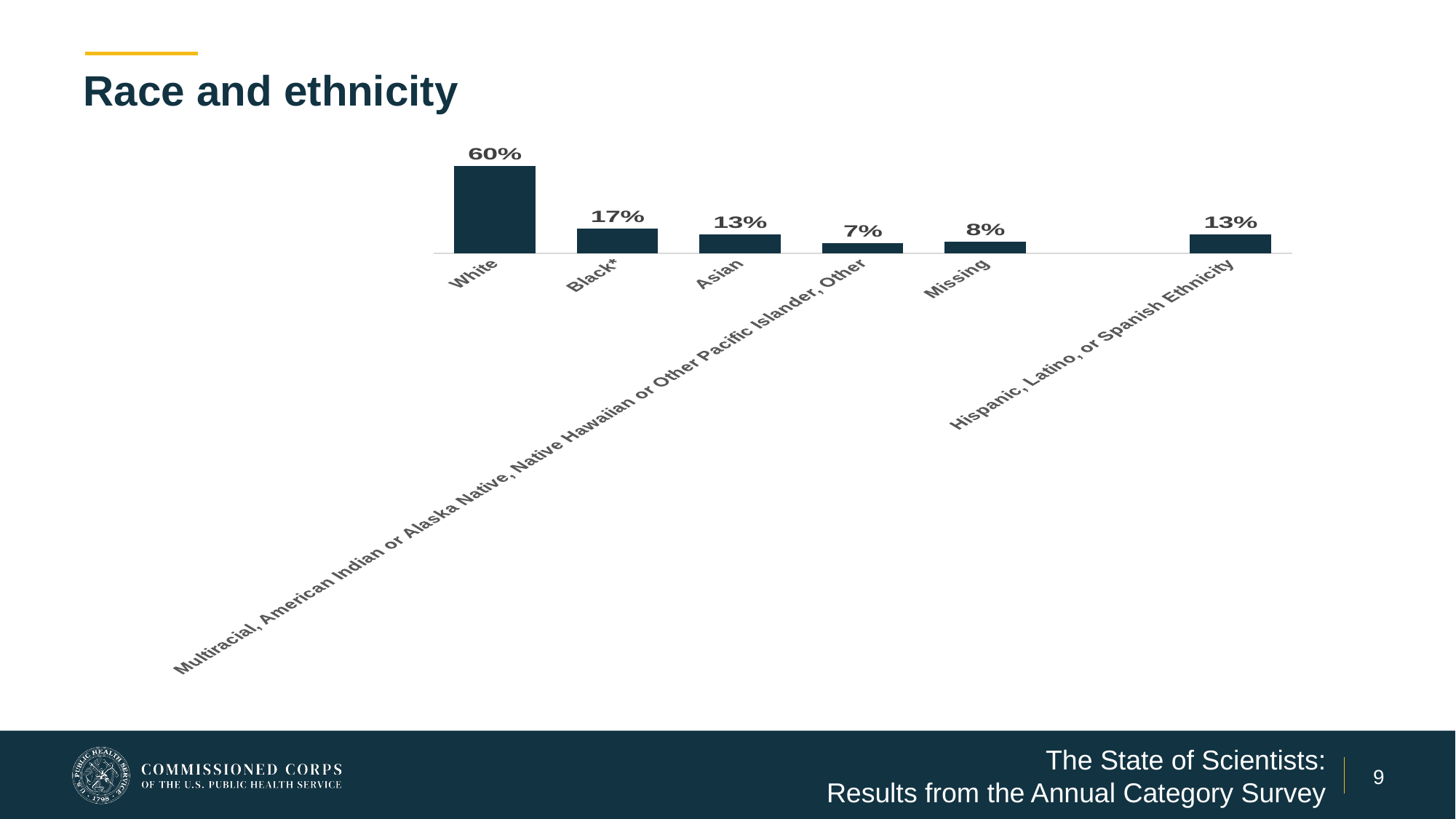
What is the difference between the percentages for White and Black*? 43% What percentage is shown for Black*? 17% What kind of chart is shown on the slide? Bar chart What is the title of the slide? Race and ethnicity Which category has the lowest percentage? Multiracial, American Indian or Alaska Native, Native Hawaiian or Other Pacific Islander, Other What percentage is shown for Missing? 8% How many categories are shown in the chart? 6 What percentage is shown for Hispanic, Latino, or Spanish Ethnicity? 13% What percentage is shown for Asian? 13% What percentage is shown for White? 60% Which is larger, the percentage for Black* or the percentage for Asian? Black* Which category has the highest percentage? White